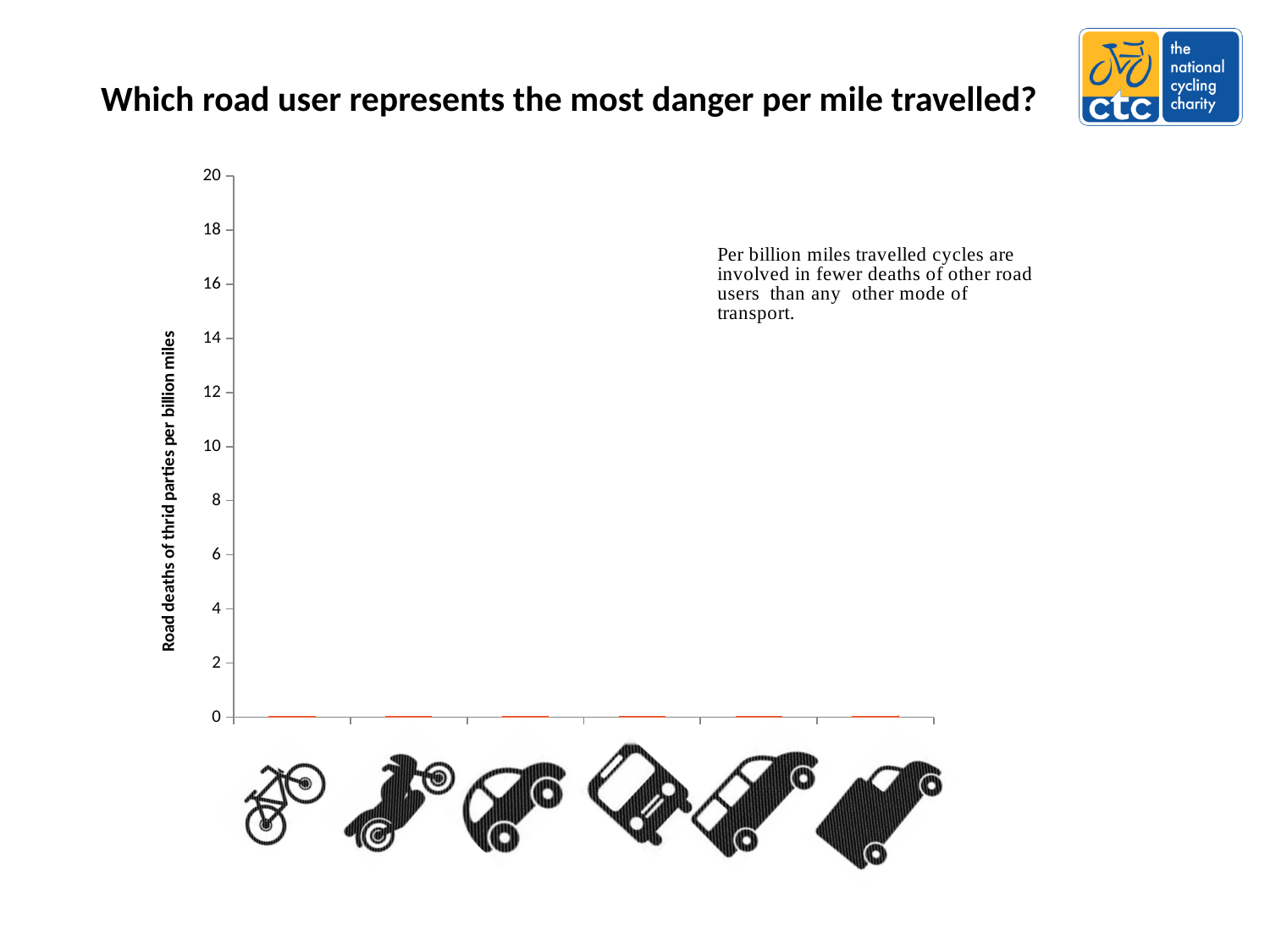
Is the value for the last (rightmost) bar greater or less than 2? less Is the value for the first (leftmost) bar greater or less than 2? less What is the highest value shown on the vertical axis of the chart? 20 What is the label on the vertical axis of the chart? Road deaths of thrid parties per billion miles Are any of the plotted bars greater than 4 on the vertical axis? No What kind of chart is shown on the slide? bar chart What is the interval between consecutive tick labels on the vertical axis? 2 How many bars (categories) are plotted on the chart? 6